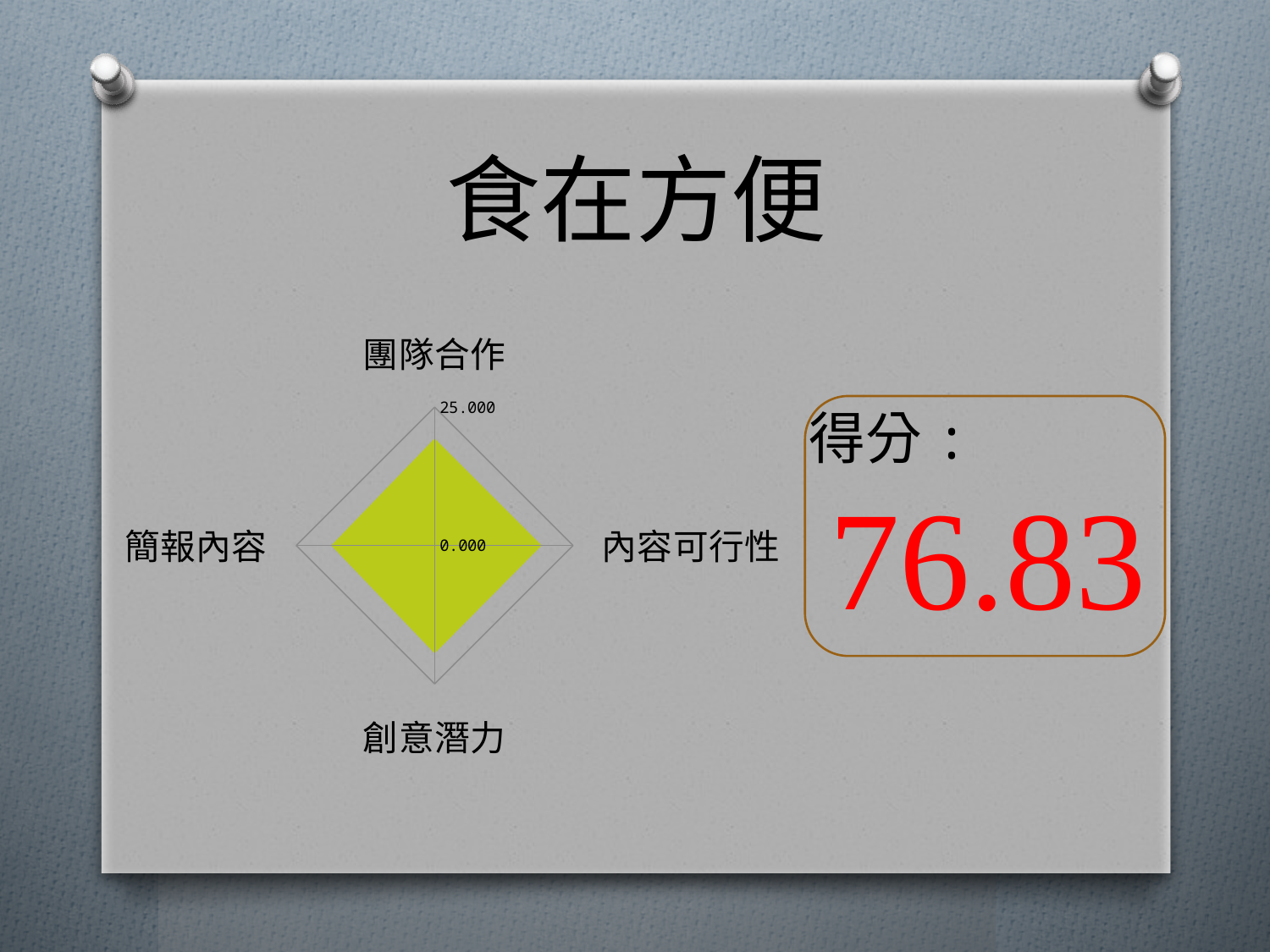
What is the maximum value shown on the radar chart's axis? 25.000 How many categories (axes) does the radar chart have? 4 What is the minimum value shown on the radar chart's axis? 0.000 Is the value for 內容可行性 greater or less than 25.000? less Is the value for 簡報內容 greater or less than 25.000? less Which category label appears at the bottom of the radar chart? 創意潛力 Is the value for 團隊合作 greater or less than 25.000? less What kind of chart is shown on the slide? Radar chart